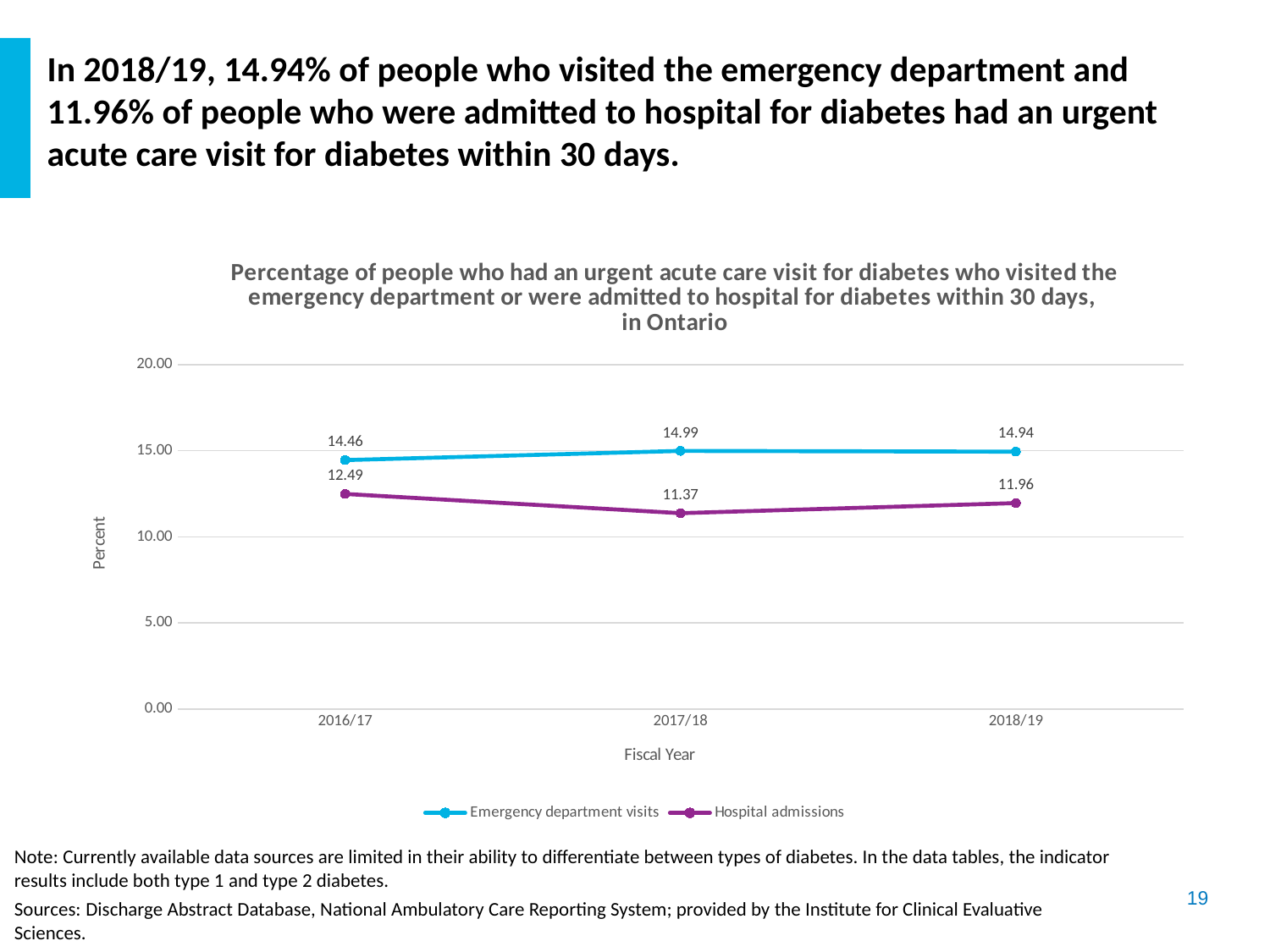
How many fiscal years are shown on the x axis? 3 How many series does the legend list? 2 What is the value for Hospital admissions in 2018/19? 11.96 In which fiscal year is the Emergency department visits value highest? 2017/18 Which series has the larger value in 2016/17, Emergency department visits or Hospital admissions? Emergency department visits In which fiscal year is the Hospital admissions value lowest? 2017/18 What is the difference between the Emergency department visits and Hospital admissions values in 2018/19? 2.98 What is the value for Hospital admissions in 2017/18? 11.37 Is the value for Hospital admissions in 2016/17 greater or less than 15.00? less What is the value for Emergency department visits in 2016/17? 14.46 What is the label of the y axis? Percent What kind of chart is shown on the slide? line chart